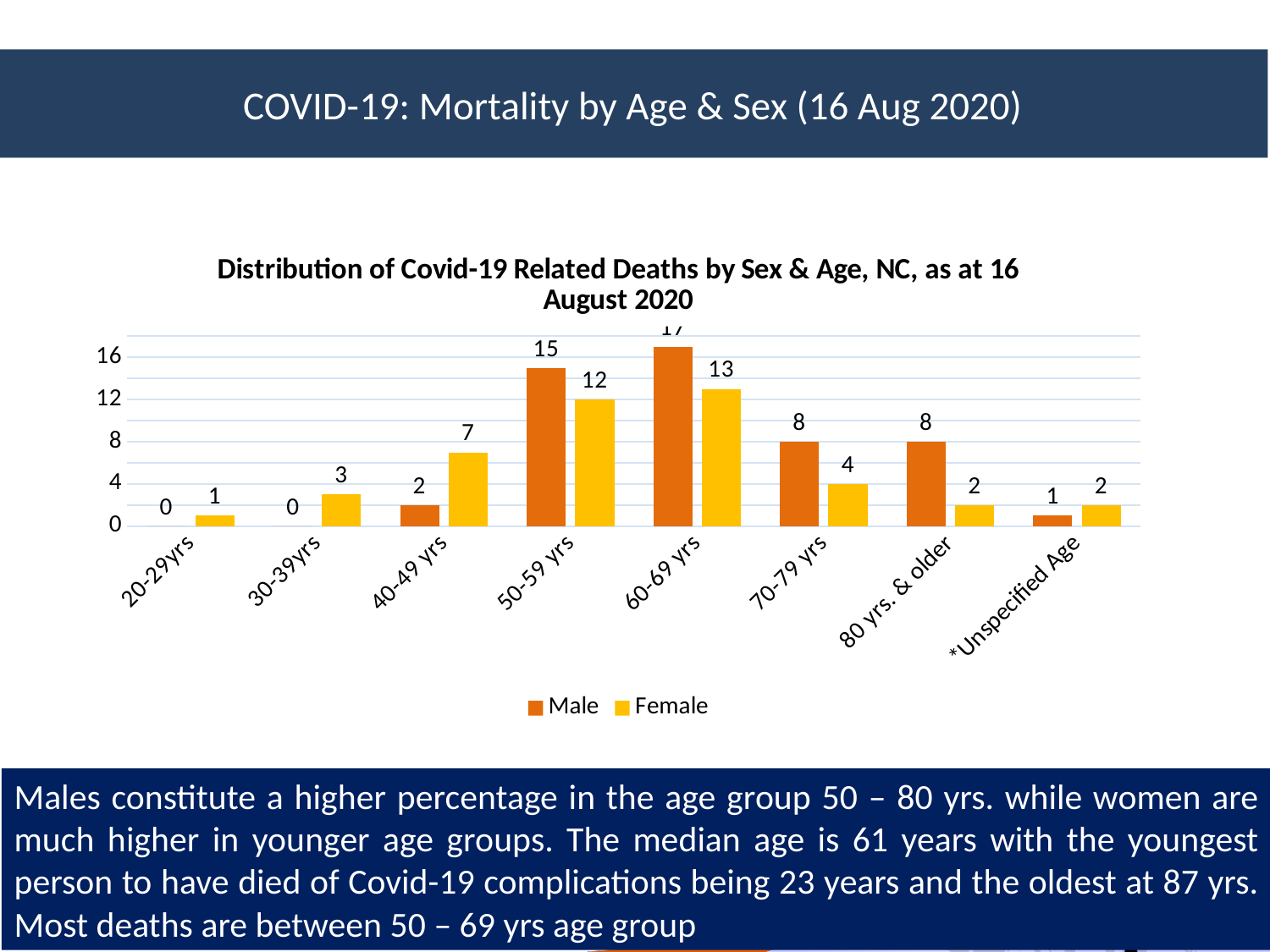
Which is larger for the 40-49 yrs age group, the Male value or the Female value? Female How many age categories are shown on the x axis? 8 How many series does the legend list? 2 What is the difference between the Male and Female values for the 70-79 yrs age group? 4 Which age group has the lowest Female value? 20-29yrs What is the Female value for the 60-69 yrs age group? 13 What type of chart is shown on the slide? bar chart Which age group has the highest Male value? 60-69 yrs What is the Male value for the 70-79 yrs age group? 8 What is the Female value for the 40-49 yrs age group? 7 What is the Male value for the 50-59 yrs age group? 15 Is the Male value for the 60-69 yrs age group greater or less than 16? greater